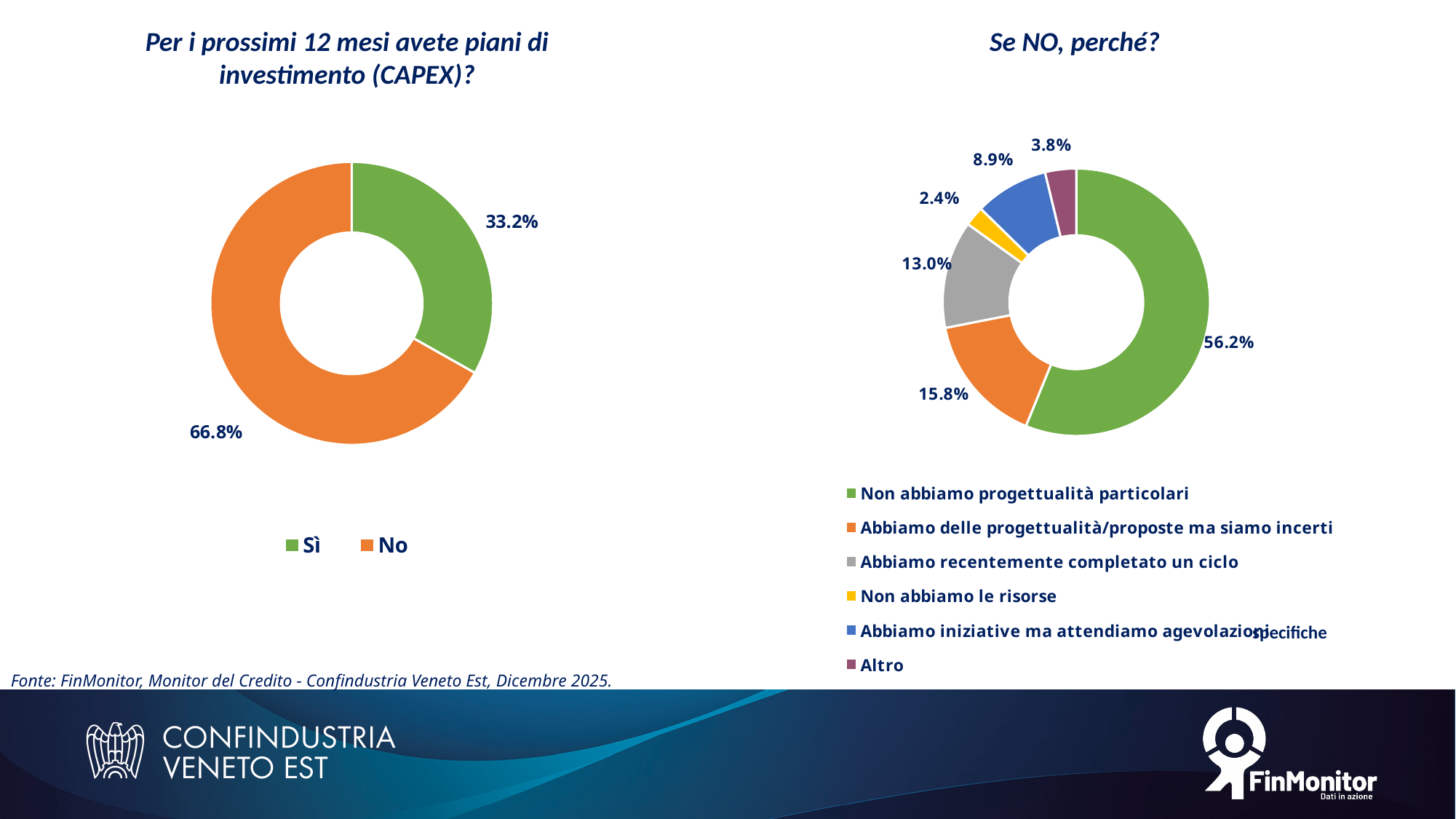
In the right chart 'Se NO, perché?', what is the value for 'Abbiamo recentemente completato un ciclo'? 13.0% In the right chart 'Se NO, perché?', what is the value for 'Non abbiamo progettualità particolari'? 56.2% In the left chart 'Per i prossimi 12 mesi avete piani di investimento (CAPEX)?', what is the difference between 'No' and 'Sì'? 33.6% In the left chart 'Per i prossimi 12 mesi avete piani di investimento (CAPEX)?', what is the value for 'No'? 66.8% In the left chart 'Per i prossimi 12 mesi avete piani di investimento (CAPEX)?', what is the value for 'Sì'? 33.2% In the right chart 'Se NO, perché?', what is the value for 'Non abbiamo le risorse'? 2.4% In the right chart 'Se NO, perché?', which category has the largest share? Non abbiamo progettualità particolari What kind of chart is the left chart 'Per i prossimi 12 mesi avete piani di investimento (CAPEX)?'? Doughnut (pie) chart How many categories does the legend of the right chart 'Se NO, perché?' list? 6 In the right chart 'Se NO, perché?', what is the difference between 'Abbiamo delle progettualità/proposte ma siamo incerti' and 'Altro'? 12.0% In the right chart 'Se NO, perché?', which is larger: 'Abbiamo delle progettualità/proposte ma siamo incerti' or 'Abbiamo iniziative ma attendiamo agevolazioni specifiche'? Abbiamo delle progettualità/proposte ma siamo incerti In the right chart 'Se NO, perché?', which category has the smallest share? Non abbiamo le risorse